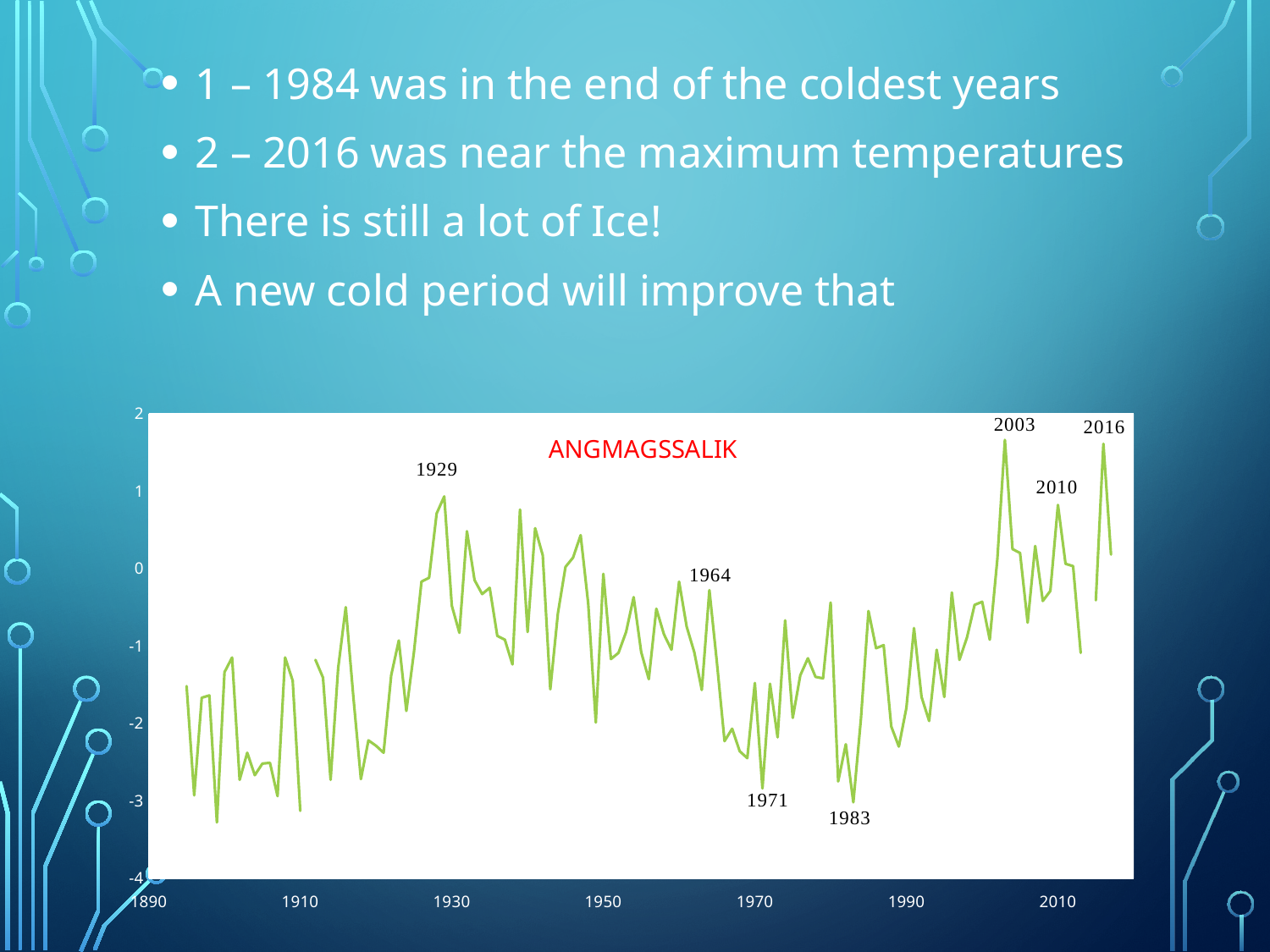
Is the value for 2003 greater or less than 1? greater Is the value for 1964 greater or less than 0? less Is the value for 1971 greater or less than -2? less Do the values rise or fall between 1983 and 2003? rise Which has the higher value, 2003 or 1929? 2003 Which has the lower value, 1983 or 1964? 1983 What is the title of the chart? ANGMAGSSALIK What colour is the line plotted in the chart? green What kind of chart is shown on the slide? line chart